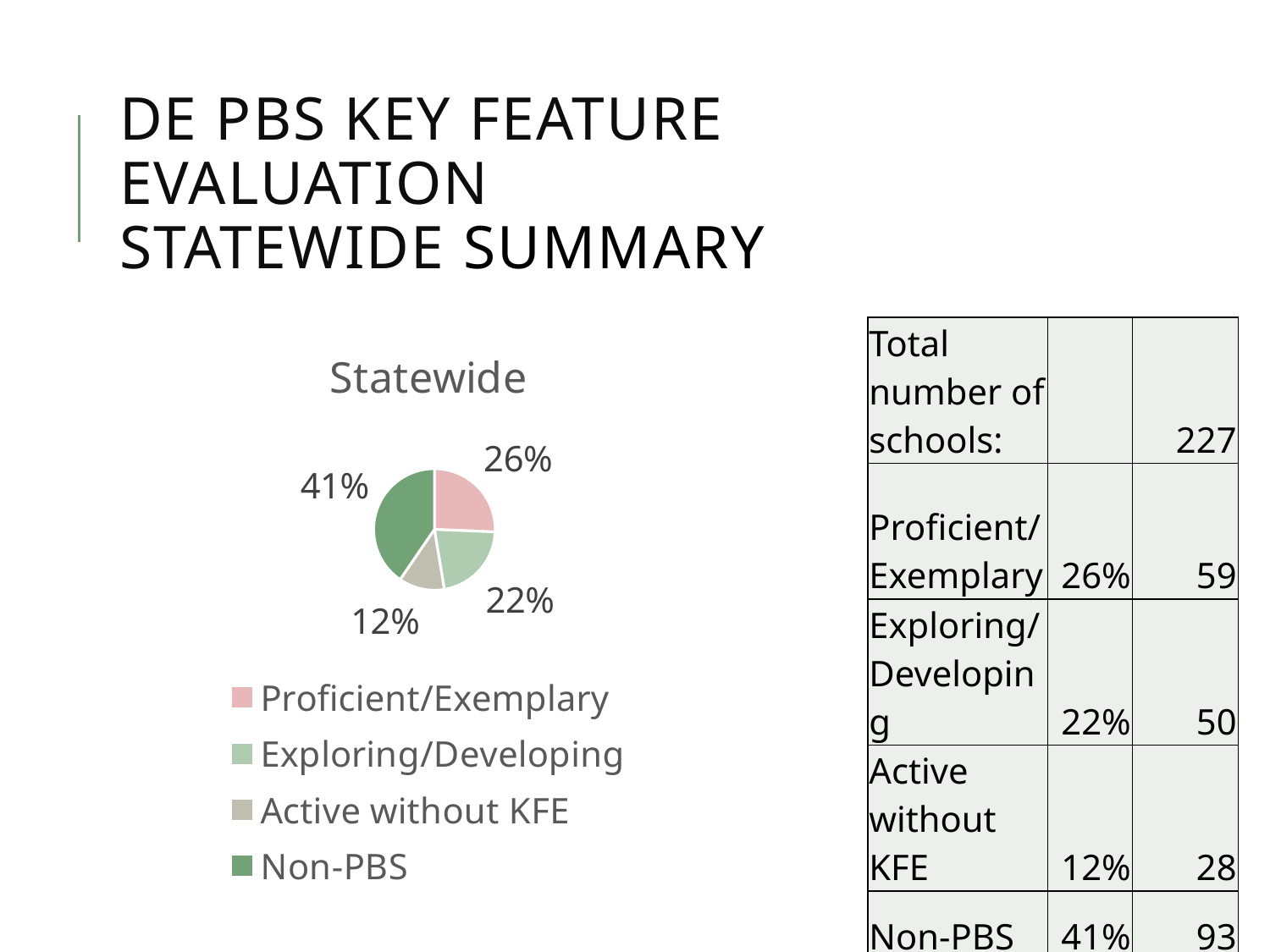
Which category has the largest slice of the pie? Non-PBS Which legend entry is shown in dark green? Non-PBS How many categories does the pie chart show? 4 What share of the pie does Exploring/Developing represent? 22% What share of the pie does Non-PBS represent? 41% What share of the pie does Proficient/Exemplary represent? 26% What is the title of the chart? Statewide What is the difference in percentage points between Non-PBS and Proficient/Exemplary? 15% Which category has the smallest slice of the pie? Active without KFE What type of chart is shown on the slide? pie chart Which is larger, the share for Proficient/Exemplary or the share for Exploring/Developing? Proficient/Exemplary